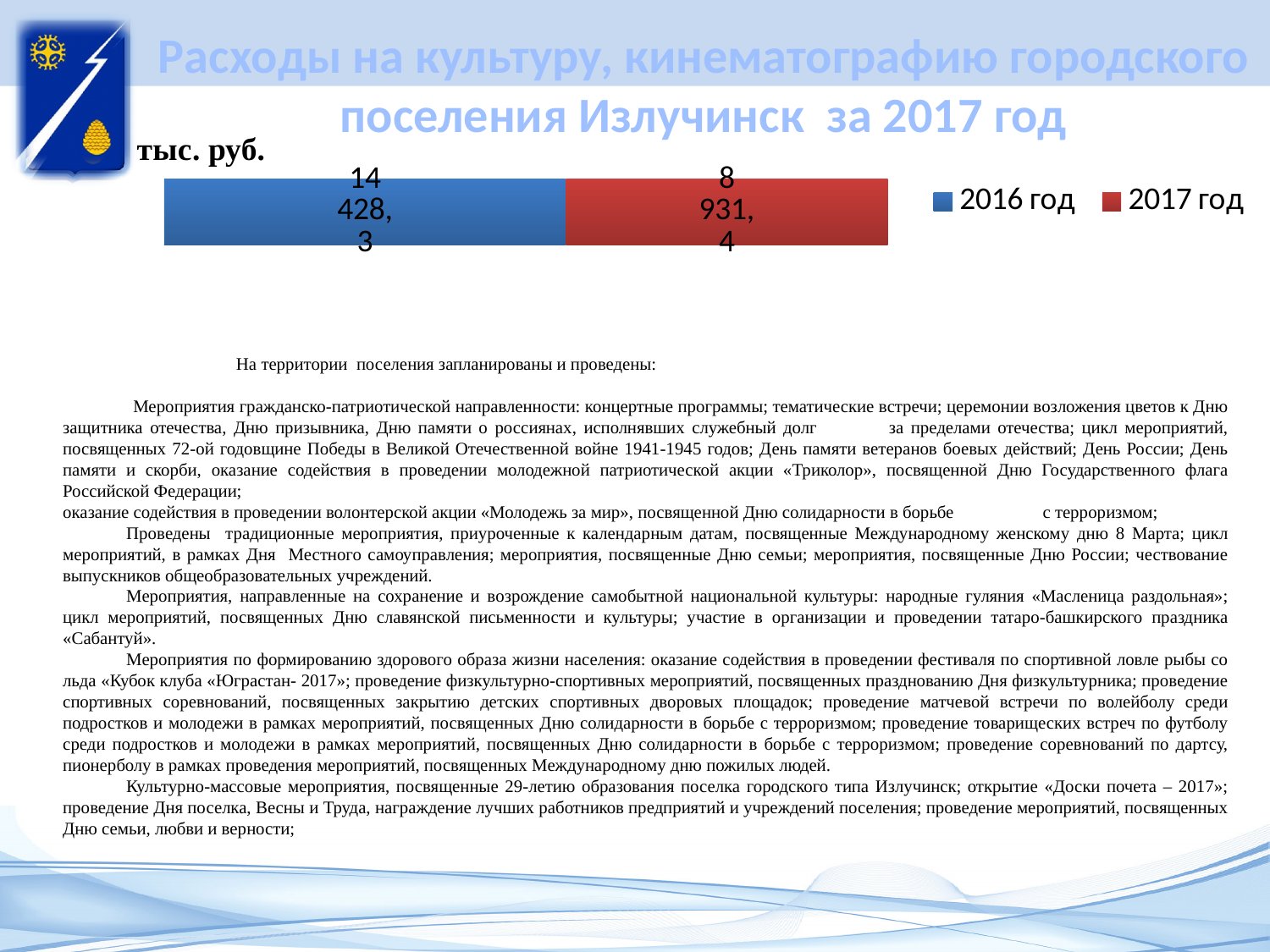
Which series has the larger value, 2016 год or 2017 год? 2016 год What unit is indicated for the chart values? тыс. руб. Which colour represents 2017 год in the chart? Red What is the total of the two segments in the stacked bar? 23 359,7 What kind of chart is shown on the slide? Bar chart Which year has the lowest value in the chart? 2017 год How many series does the legend list? 2 What is the value for 2016 год in the chart? 14 428,3 What is the value for 2017 год in the chart? 8 931,4 Which year has the highest value in the chart? 2016 год What is the difference between the values for 2016 год and 2017 год? 5 496,9